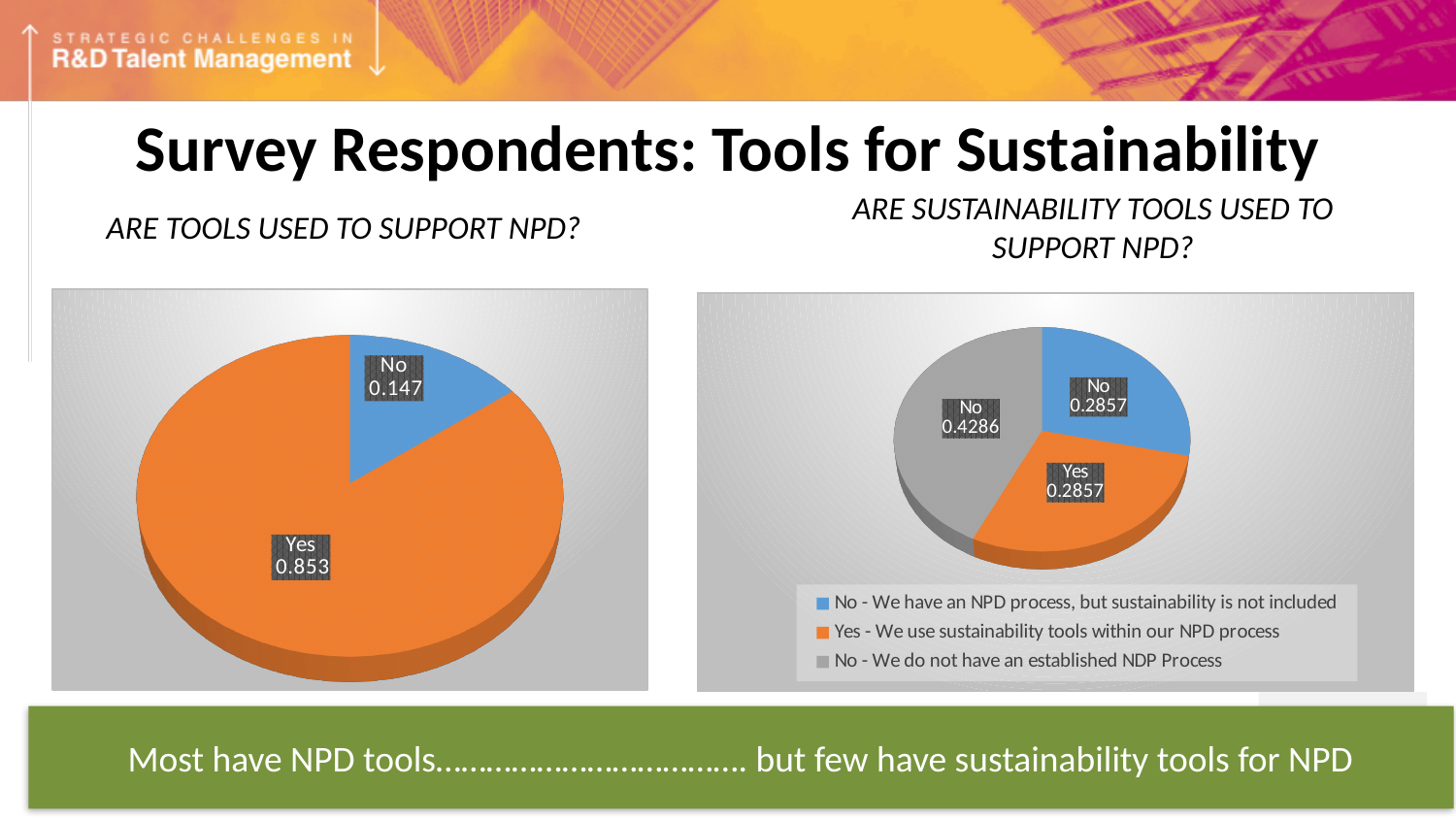
In the chart titled 'ARE TOOLS USED TO SUPPORT NPD?', which slice is the largest? Yes In the chart titled 'ARE SUSTAINABILITY TOOLS USED TO SUPPORT NPD?', which is larger: the value for 'No - We do not have an established NDP Process' or the value for 'Yes - We use sustainability tools within our NPD process'? No - We do not have an established NDP Process In the chart titled 'ARE TOOLS USED TO SUPPORT NPD?', what is the value for Yes? 0.853 In the chart titled 'ARE SUSTAINABILITY TOOLS USED TO SUPPORT NPD?', what colour is the slice for 'No - We have an NPD process, but sustainability is not included'? Blue In the chart titled 'ARE SUSTAINABILITY TOOLS USED TO SUPPORT NPD?', what is the value for 'Yes - We use sustainability tools within our NPD process'? 0.2857 In the chart titled 'ARE TOOLS USED TO SUPPORT NPD?', what is the difference between the Yes and No values? 0.706 In the chart titled 'ARE SUSTAINABILITY TOOLS USED TO SUPPORT NPD?', how many entries does the legend list? 3 In the chart titled 'ARE SUSTAINABILITY TOOLS USED TO SUPPORT NPD?', how many slices does the pie have? 3 In the chart titled 'ARE SUSTAINABILITY TOOLS USED TO SUPPORT NPD?', what is the value for 'No - We do not have an established NDP Process'? 0.4286 In the chart titled 'ARE TOOLS USED TO SUPPORT NPD?', what is the value for No? 0.147 In the chart titled 'ARE SUSTAINABILITY TOOLS USED TO SUPPORT NPD?', which legend category has the largest slice? No - We do not have an established NDP Process What kind of chart is the left chart on the slide? Pie chart